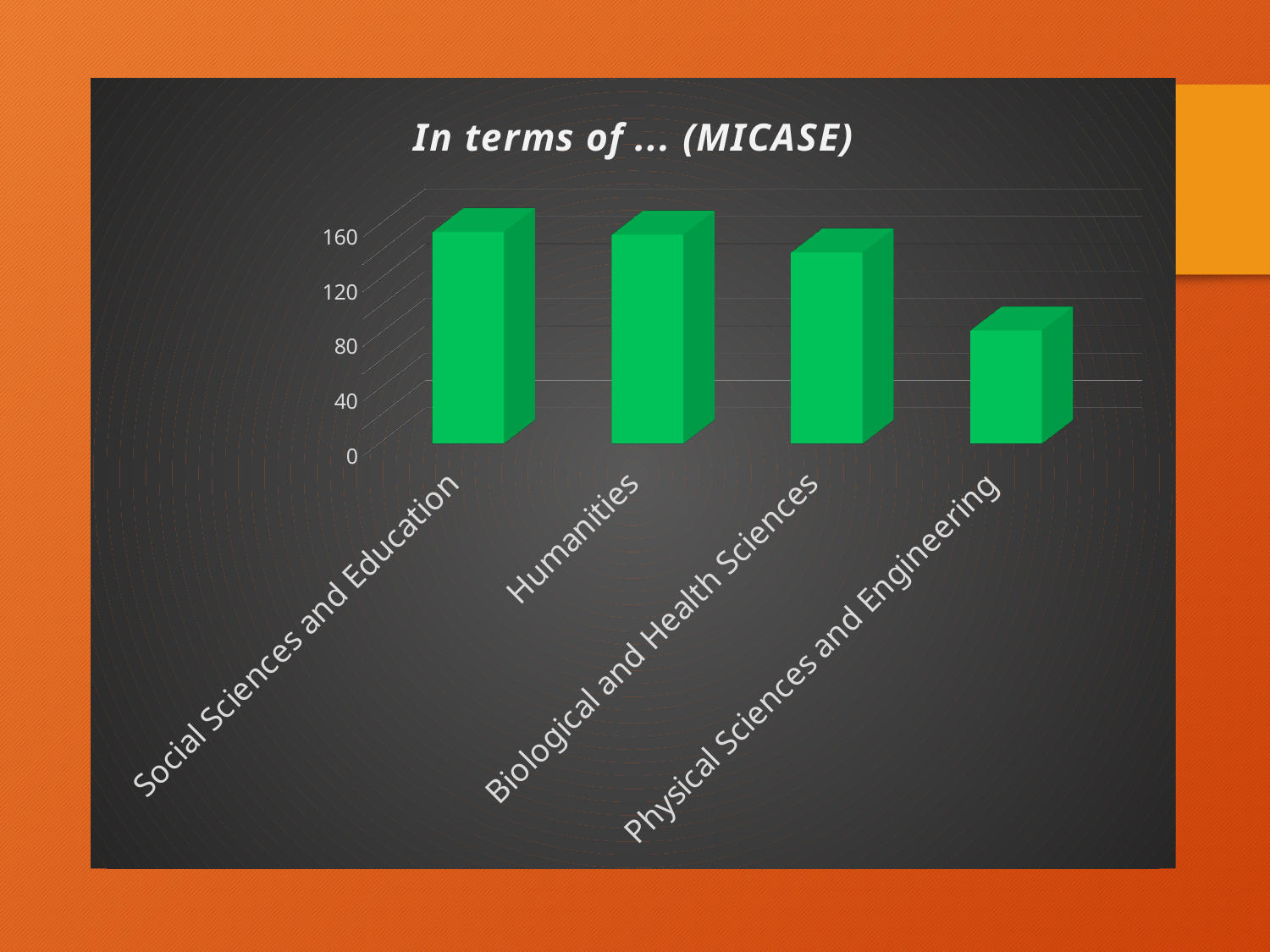
Which is larger, the value for Biological and Health Sciences or the value for Physical Sciences and Engineering? Biological and Health Sciences Do the values rise or fall moving from left to right along the x axis? fall Is the value for Physical Sciences and Engineering greater or less than 120? less What kind of chart is shown on the slide? bar chart Is the value for Humanities greater or less than 80? greater Is the value for Physical Sciences and Engineering greater or less than 40? greater Which is larger, the value for Social Sciences and Education or the value for Physical Sciences and Engineering? Social Sciences and Education What is the title of the chart? In terms of … (MICASE) Which category has the lowest value in the chart? Physical Sciences and Engineering How many categories are plotted in the chart? 4